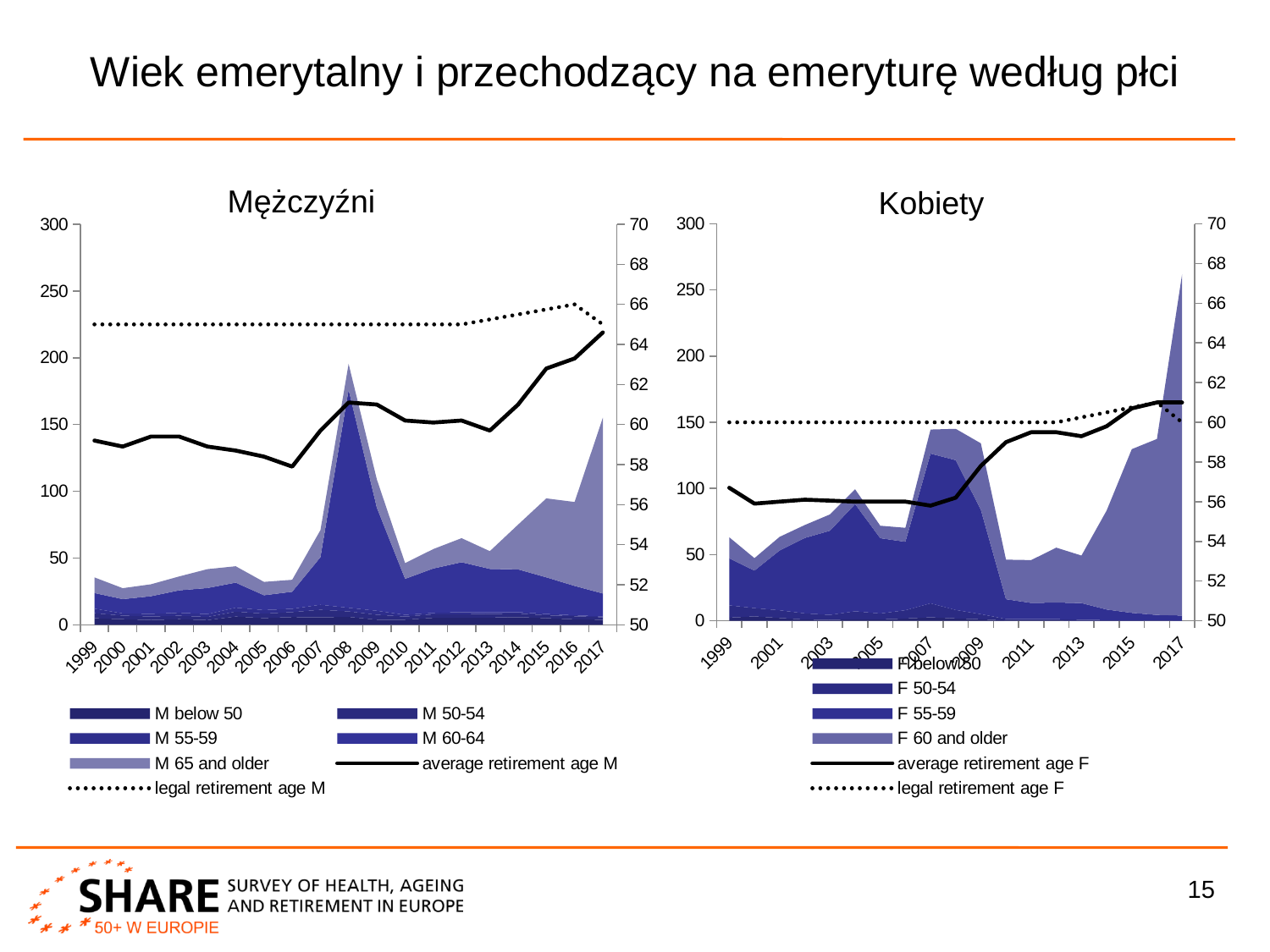
In the Mężczyźni chart, which year has the highest stacked total of the age groups? 2008 What is the title of the left chart? Mężczyźni In the Mężczyźni chart, is the average retirement age M in 2006 greater or less than 60? less How many years are labelled on the x axis of the Mężczyźni chart? 19 In the Kobiety chart, which year has the highest stacked total of the age groups? 2017 In the Kobiety chart, is the average retirement age F in 1999 greater or less than 58? less In the Mężczyźni chart, does the average retirement age M rise or fall between 2013 and 2017? rise In the Mężczyźni chart, is the average retirement age M in 2017 greater or less than 62? greater What kind of chart is the Mężczyźni chart? Stacked area chart combined with line chart How many series does the legend of the Kobiety chart list? 6 How many series does the legend of the Mężczyźni chart list? 7